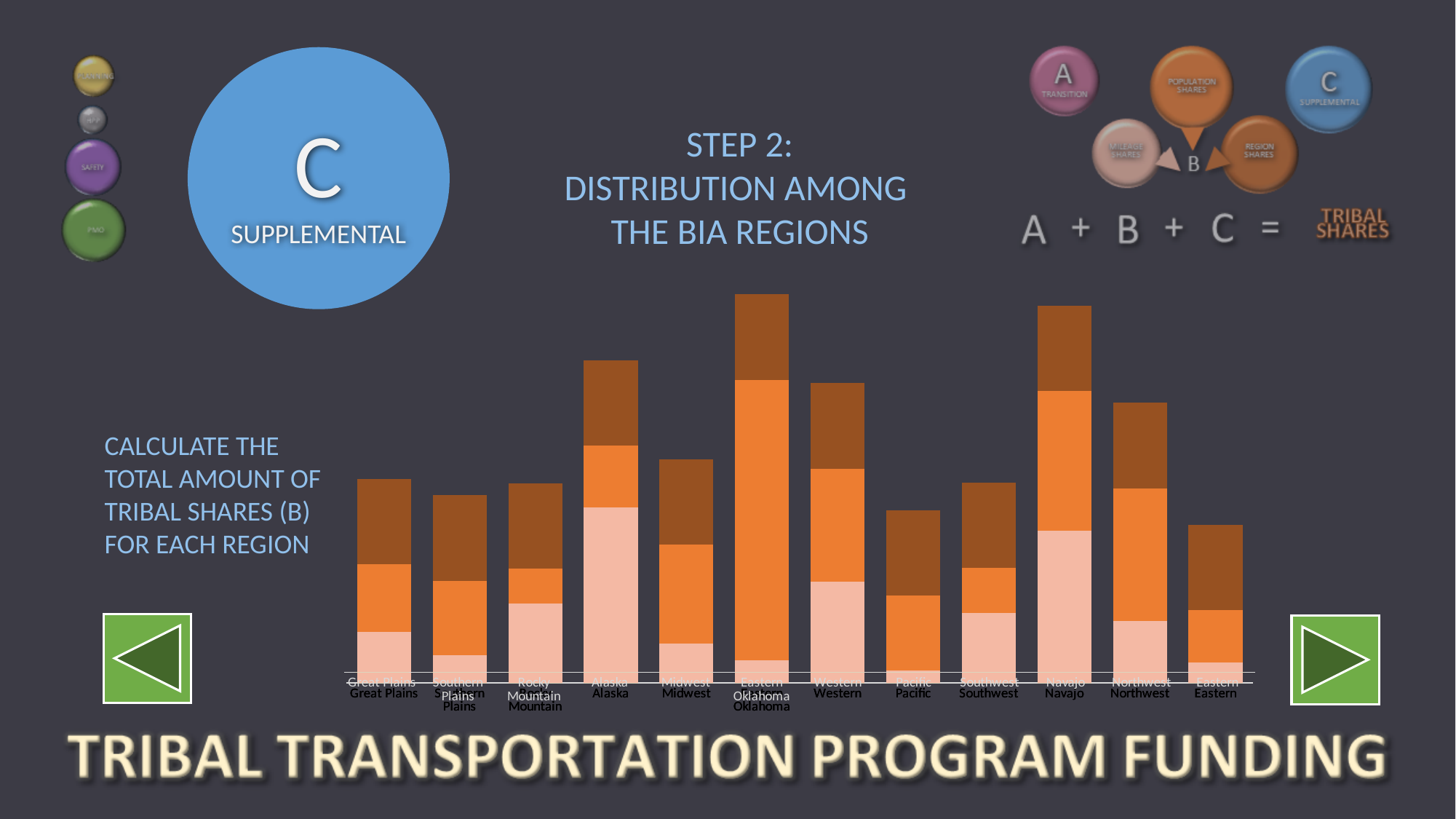
Which region has the largest light pink (bottom) segment? Alaska Which region has the shortest bar on the chart? Eastern What kind of chart is shown on the slide? Stacked bar chart How many stacked segments make up each bar? 3 Which bar is taller, Western or Northwest? Western Which region's bar is the second tallest on the chart? Navajo Which bar is taller, Alaska or Midwest? Alaska How many BIA regions are shown as categories on the chart? 12 Which region has the tallest bar on the chart? Eastern Oklahoma